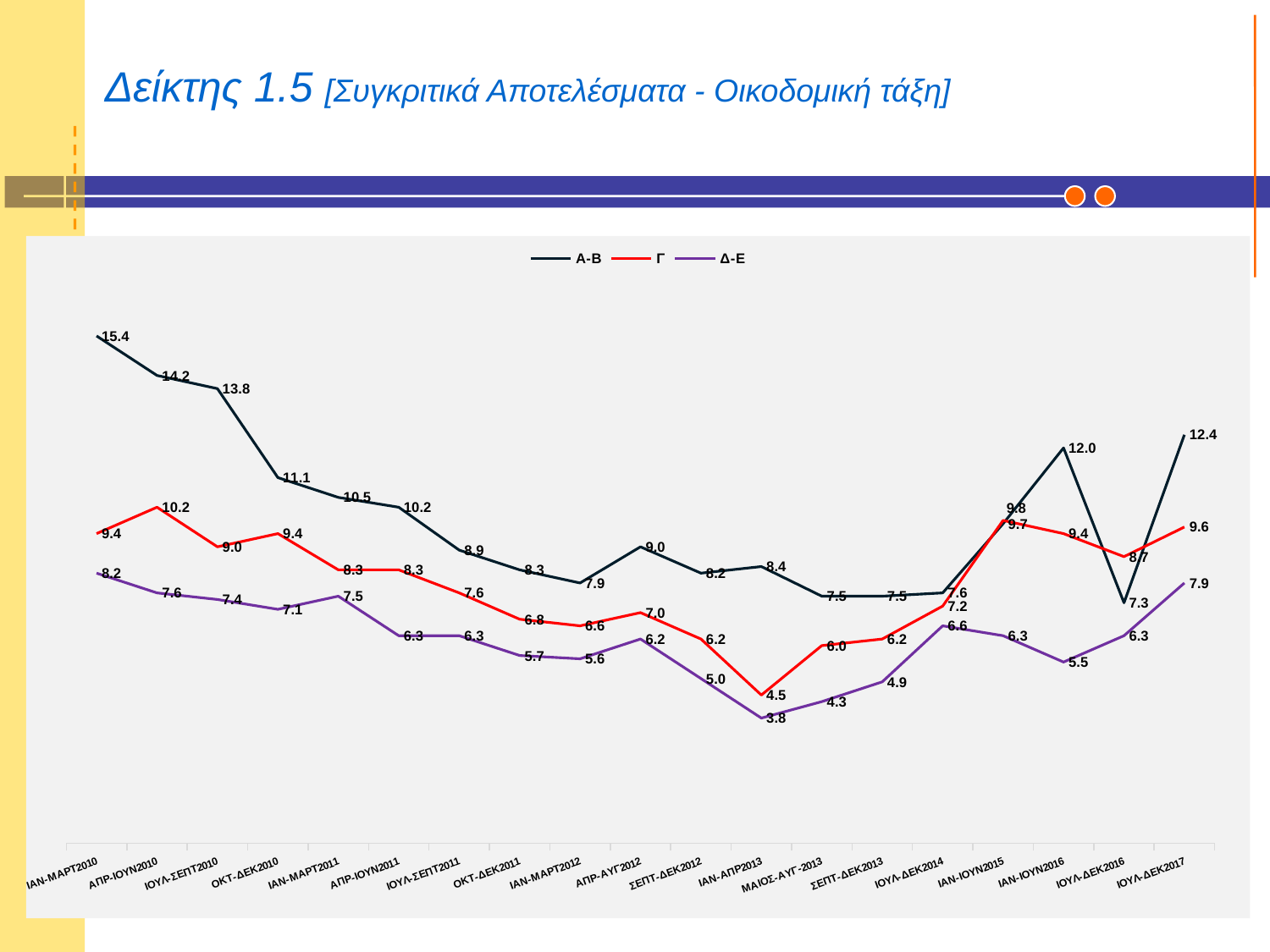
Which series has the larger value at ΙΟΥΛ-ΔΕΚ2016, Α-Β or Γ? Γ At which period does the Δ-Ε series reach its lowest value? ΙΑΝ-ΑΠΡ2013 What type of chart is shown on the slide? line chart What is the value of the Δ-Ε series at ΙΟΥΛ-ΔΕΚ2017? 7.9 Does the Α-Β series rise or fall from ΙΑΝ-ΜΑΡΤ2010 to ΟΚΤ-ΔΕΚ2011? fall How many series does the legend list? 3 What is the value of the Α-Β series at ΙΑΝ-ΜΑΡΤ2010? 15.4 What is the value of the Γ series at ΙΑΝ-ΑΠΡ2013? 4.5 What colour is the line for the Γ series? red At which period does the Α-Β series reach its highest value? ΙΑΝ-ΜΑΡΤ2010 What is the difference between the Α-Β value and the Γ value at ΙΟΥΛ-ΔΕΚ2017? 2.8 How many periods are shown on the x axis? 19